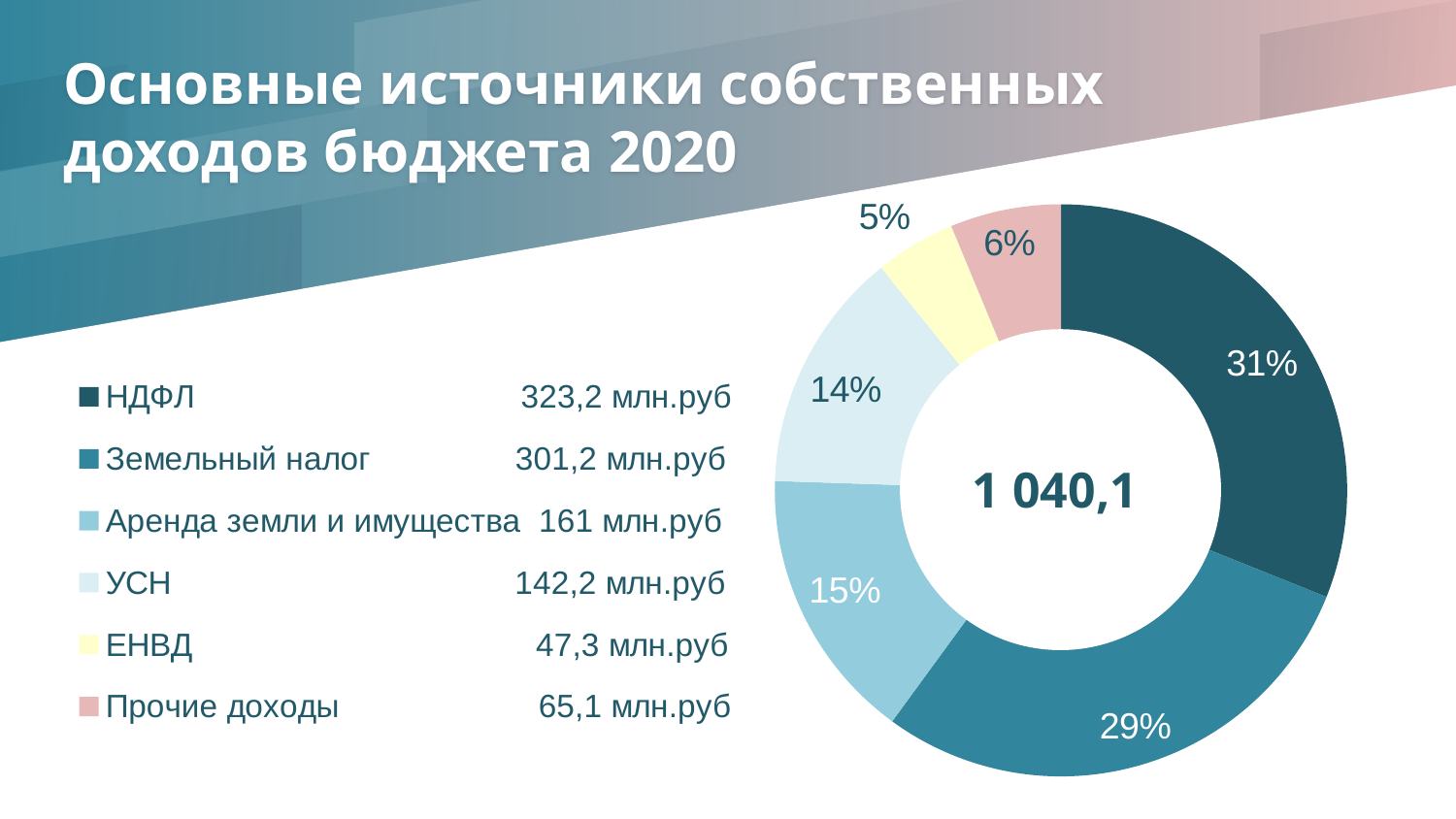
What is the value shown for Аренда земли и имущества? 161 млн.руб What kind of chart is shown on the slide? Donut (pie) chart What share of the chart does ЕНВД account for? 5% What share of the chart does Земельный налог account for? 29% What is the value shown for УСН? 142,2 млн.руб What share of the chart does НДФЛ account for? 31% How many categories does the chart show? 6 What total is shown in the centre of the donut chart? 1 040,1 Which category has the smallest share of the chart? ЕНВД Which is larger, the value for Прочие доходы or the value for ЕНВД? Прочие доходы What is the difference between the values for НДФЛ and Земельный налог? 22 млн.руб Which category has the largest share of the chart? НДФЛ